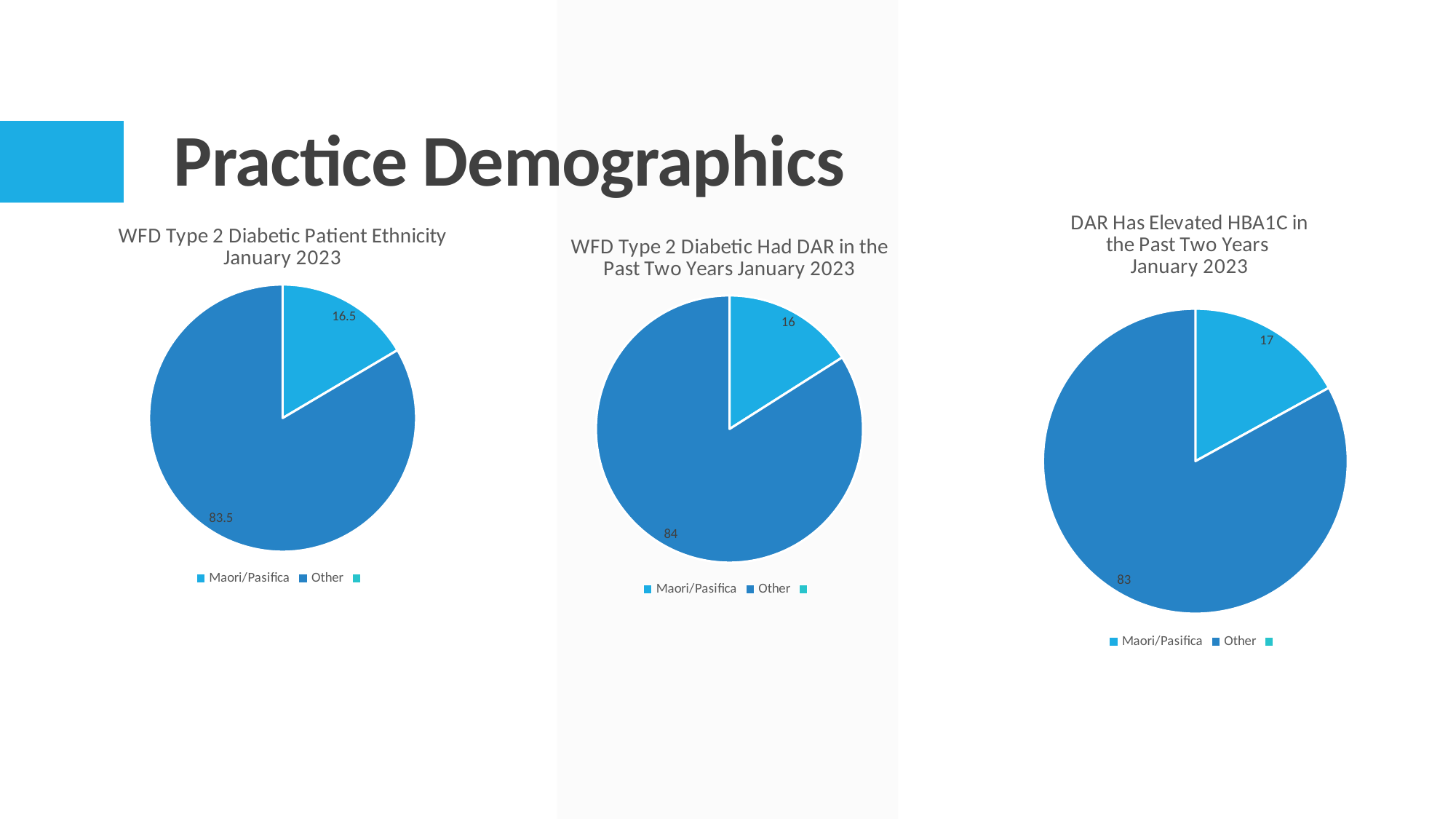
In the 'WFD Type 2 Diabetic Patient Ethnicity January 2023' chart, what is the difference between the Other and Maori/Pasifica values? 67 How many pie charts are shown on the slide? 3 In the 'DAR Has Elevated HBA1C in the Past Two Years January 2023' chart, what is the value for Other? 83 In the 'WFD Type 2 Diabetic Patient Ethnicity January 2023' chart, what is the value for Maori/Pasifica? 16.5 In the 'WFD Type 2 Diabetic Had DAR in the Past Two Years January 2023' chart, which is larger, Maori/Pasifica or Other? Other In the 'WFD Type 2 Diabetic Patient Ethnicity January 2023' chart, what is the value for Other? 83.5 What kind of chart is the 'DAR Has Elevated HBA1C in the Past Two Years January 2023' chart? Pie chart In the 'WFD Type 2 Diabetic Had DAR in the Past Two Years January 2023' chart, what is the value for Maori/Pasifica? 16 In the 'DAR Has Elevated HBA1C in the Past Two Years January 2023' chart, what is the value for Maori/Pasifica? 17 In the 'WFD Type 2 Diabetic Had DAR in the Past Two Years January 2023' chart, what is the value for Other? 84 In the 'DAR Has Elevated HBA1C in the Past Two Years January 2023' chart, which category has the smallest slice? Maori/Pasifica In the 'WFD Type 2 Diabetic Patient Ethnicity January 2023' chart, which category has the largest slice? Other